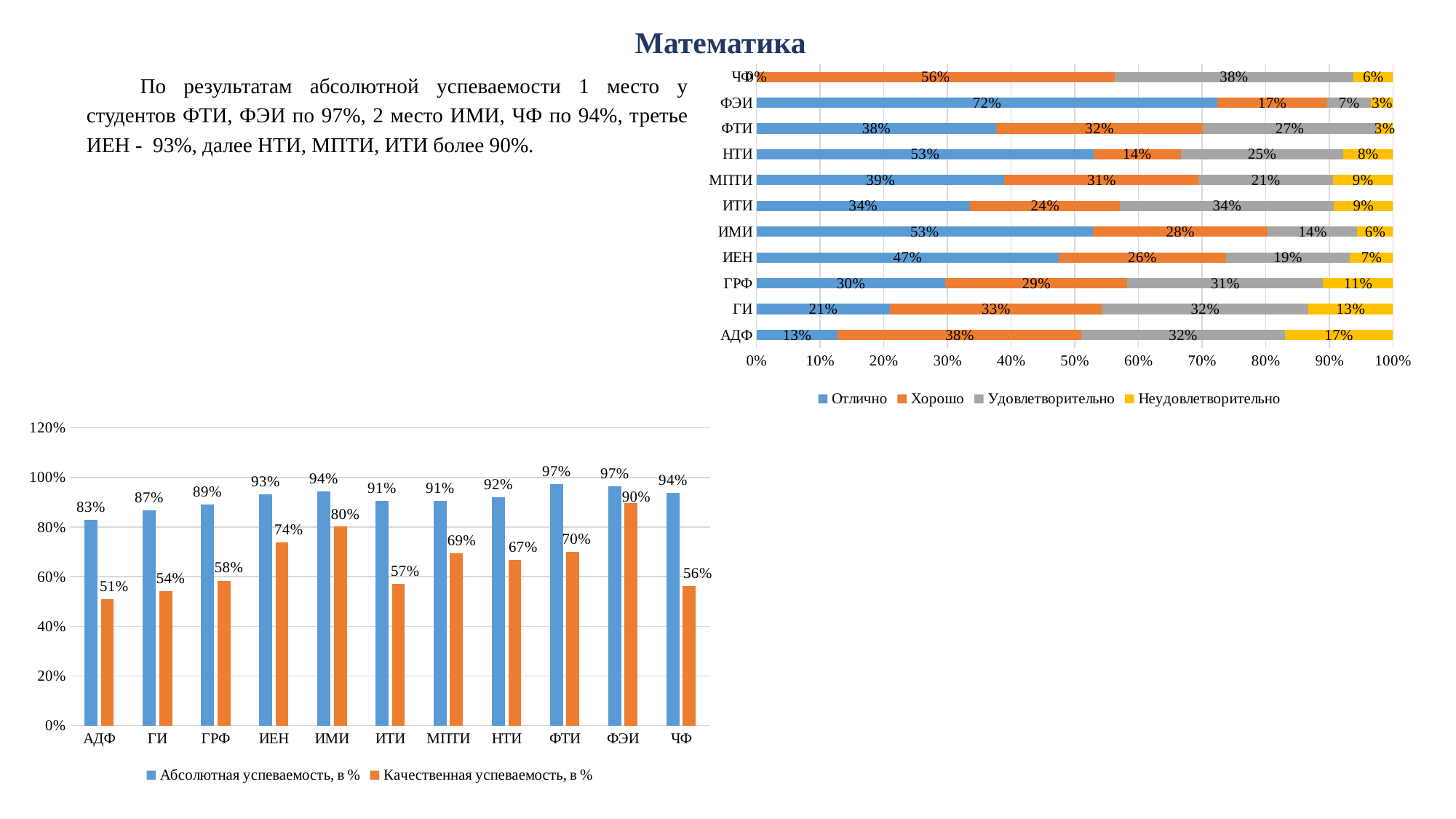
In the bottom-left chart, which is larger: Качественная успеваемость for ИЕН or for ЧФ? ИЕН What kind of chart is the top-right chart? Stacked horizontal bar chart In the top-right chart, what is the Неудовлетворительно value for АДФ? 17% In the top-right chart, what is the Отлично value for ФЭИ? 72% In the bottom-left chart, what is the value of Абсолютная успеваемость for АДФ? 83% In the top-right chart, which category has the highest Отлично value? ФЭИ In the bottom-left chart, which category has the highest Качественная успеваемость? ФЭИ How many series does the legend of the top-right chart list? 4 In the bottom-left chart, what is the value of Качественная успеваемость for ИМИ? 80% How many categories are shown on the x axis of the bottom-left chart? 11 In the bottom-left chart, what is the difference between Абсолютная успеваемость and Качественная успеваемость for ИЕН? 19 percentage points In the bottom-left chart, which category has the lowest Абсолютная успеваемость? АДФ